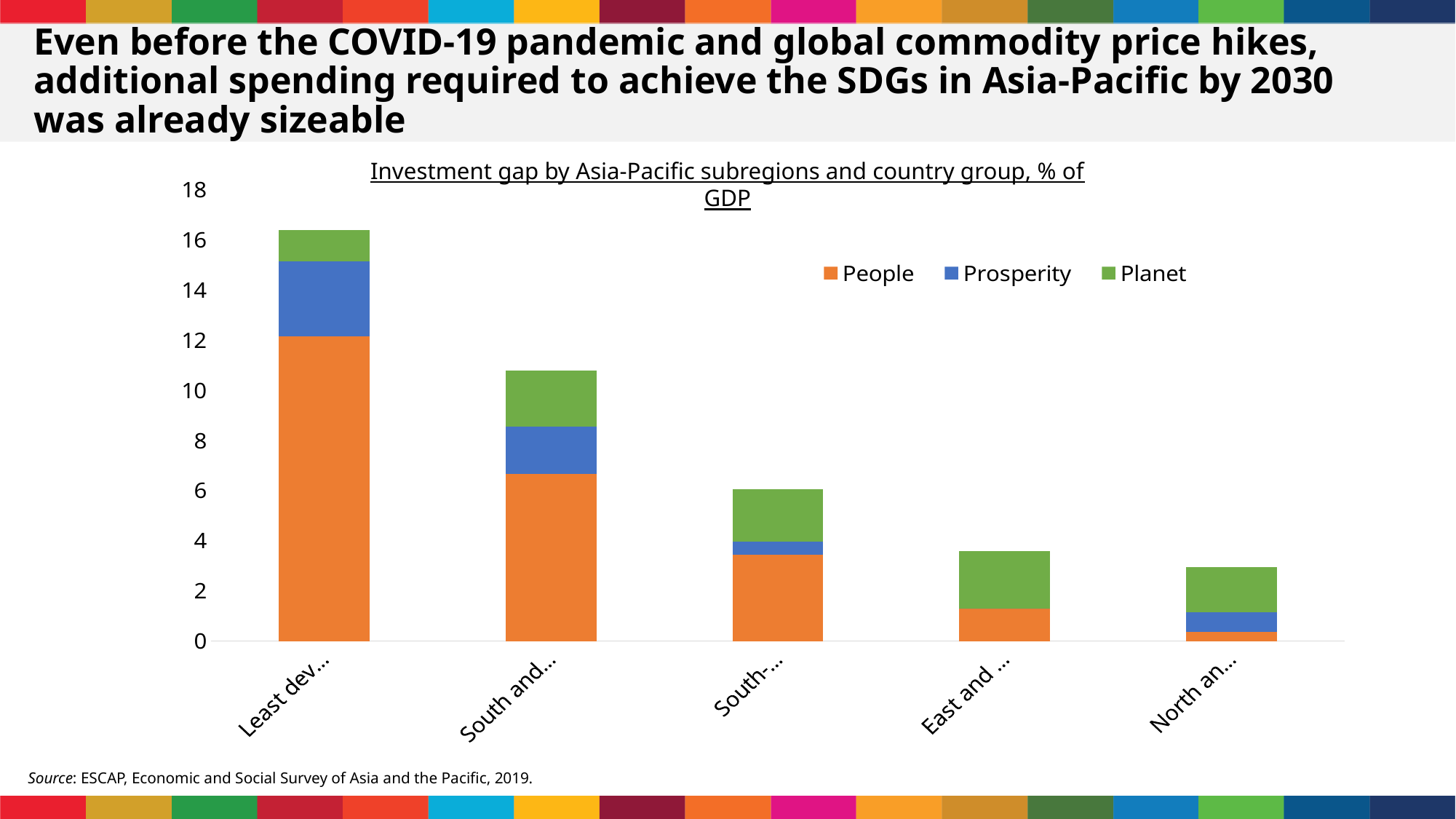
What kind of chart is shown on the slide? Stacked bar chart How many bars (subregions/country groups) are plotted in the chart? 5 What is the title of the chart? Investment gap by Asia-Pacific subregions and country group, % of GDP What are the three series named in the legend? People, Prosperity, Planet Is the total value for the second bar (South and...) greater or less than 10? greater Which bar has the highest total investment gap? Least dev... (the first bar) Is the total value for the first bar (Least dev...) greater or less than 14? greater Is the total value for the fourth bar (East and ...) greater or less than 4? less Which bar has the larger People segment, the first bar (Least dev...) or the second bar (South and...)? Least dev... (the first bar) Which bar has the lowest total investment gap? North an... (the last bar) Do the total bar values rise or fall moving from left to right along the x axis? fall How many series does the legend list? 3